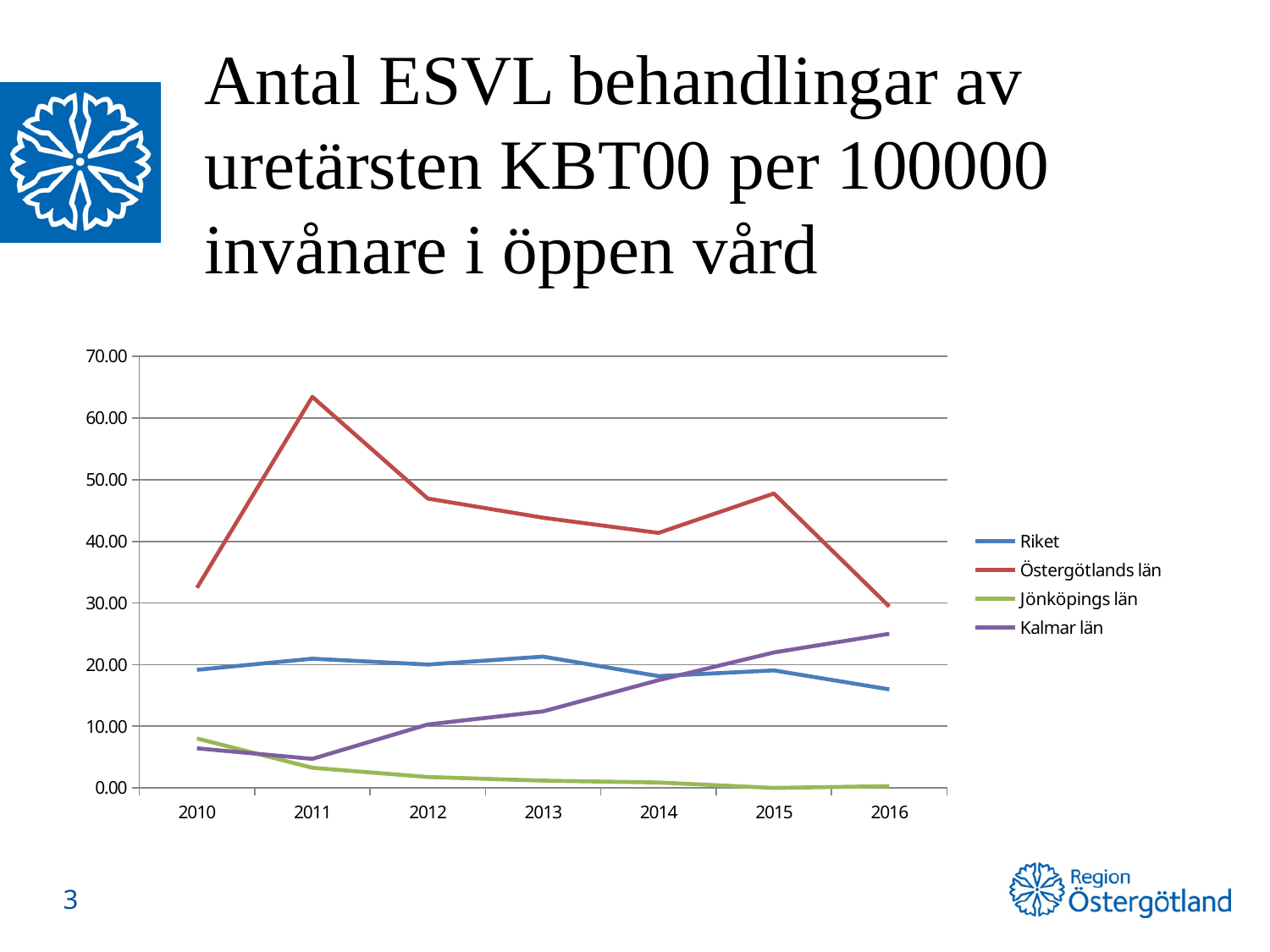
Is the value for Riket in 2016 greater or less than 20.00? less Which series has the lowest value in 2016? Jönköpings län Is the value for Östergötlands län in 2011 greater or less than 60.00? greater How many series does the legend list? 4 What colour is the line for Östergötlands län? Red Which series has the highest value in 2011? Östergötlands län What kind of chart is shown on the slide? Line chart Does the Jönköpings län series rise or fall from 2010 to 2015? fall How many years are plotted along the x axis? 7 Does the Kalmar län series rise or fall from 2011 to 2016? rise Is the value for Kalmar län in 2016 greater or less than 20.00? greater In 2016, which is larger: the value for Kalmar län or the value for Riket? Kalmar län